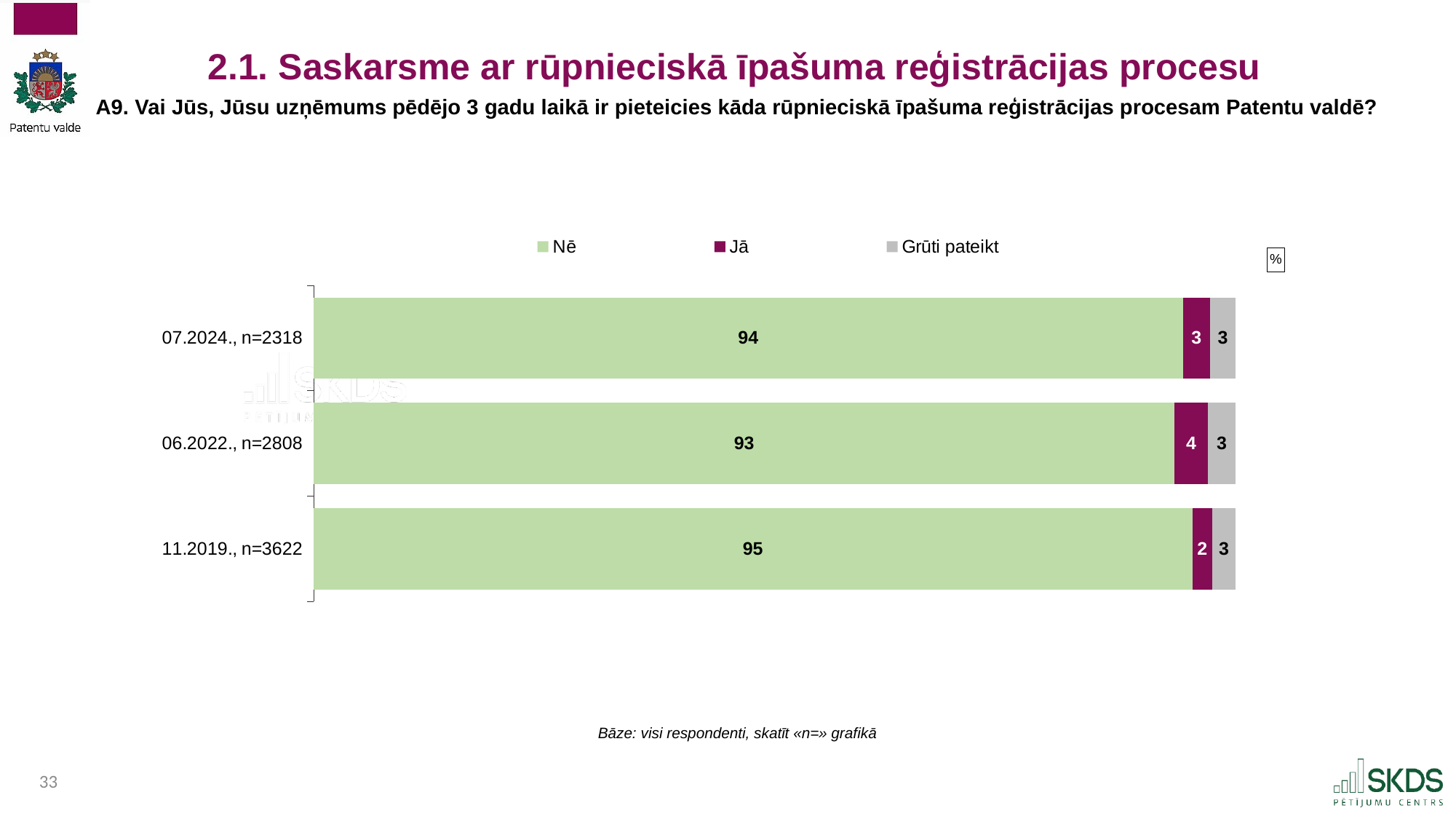
How many survey waves (bars) are shown in the chart? 3 What is the total of the 06.2022., n=2808 stacked bar? 100 What kind of chart is shown on the slide? Stacked bar chart Which survey wave has the lowest value for "Jā"? 11.2019., n=3622 Which is larger: the "Nē" value for 07.2024., n=2318 or for 06.2022., n=2808? 07.2024., n=2318 What is the value for "Jā" in the 06.2022., n=2808 bar? 4 Which survey wave has the highest value for "Nē"? 11.2019., n=3622 How many series does the legend list? 3 What is the difference between the "Jā" values for 06.2022., n=2808 and 11.2019., n=3622? 2 What is the value for "Nē" in the 07.2024., n=2318 bar? 94 Which legend entry is shown in green? Nē What is the value for "Grūti pateikt" in the 11.2019., n=3622 bar? 3